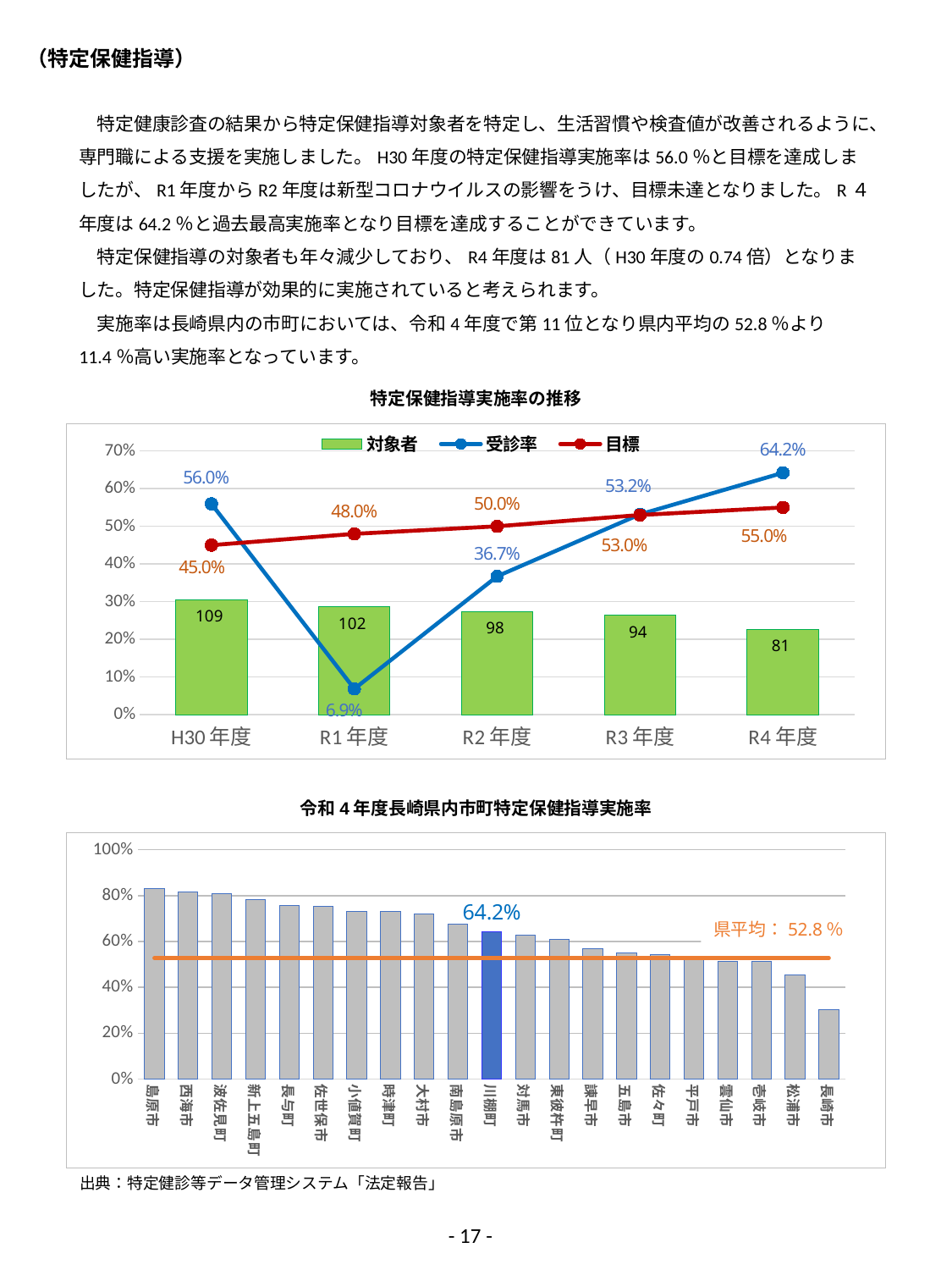
In the chart titled 令和4年度長崎県内市町特定保健指導実施率, how many municipalities are shown? 21 In the chart titled 令和4年度長崎県内市町特定保健指導実施率, what is the value for 川棚町? 64.2% In the chart titled 特定保健指導実施率の推移, what is the difference between the 受診率 and the 目標 for R4年度? 9.2% In the chart titled 令和4年度長崎県内市町特定保健指導実施率, which municipality has the lowest value? 長崎市 In the chart titled 特定保健指導実施率の推移, what is the 目標 value for R2年度? 50.0% In the chart titled 特定保健指導実施率の推移, is the 受診率 for R3年度 greater or less than the 目標 for R3年度? greater In the chart titled 特定保健指導実施率の推移, what is the 受診率 value for R4年度? 64.2% In the chart titled 特定保健指導実施率の推移, which year has the lowest 受診率? R1年度 In the chart titled 特定保健指導実施率の推移, what is the 対象者 value for H30年度? 109 In the chart titled 令和4年度長崎県内市町特定保健指導実施率, is the value for 島原市 greater or less than 80%? greater In the chart titled 特定保健指導実施率の推移, does the 対象者 value rise or fall from H30年度 to R4年度? fall In the chart titled 特定保健指導実施率の推移, how many series does the legend list? 3